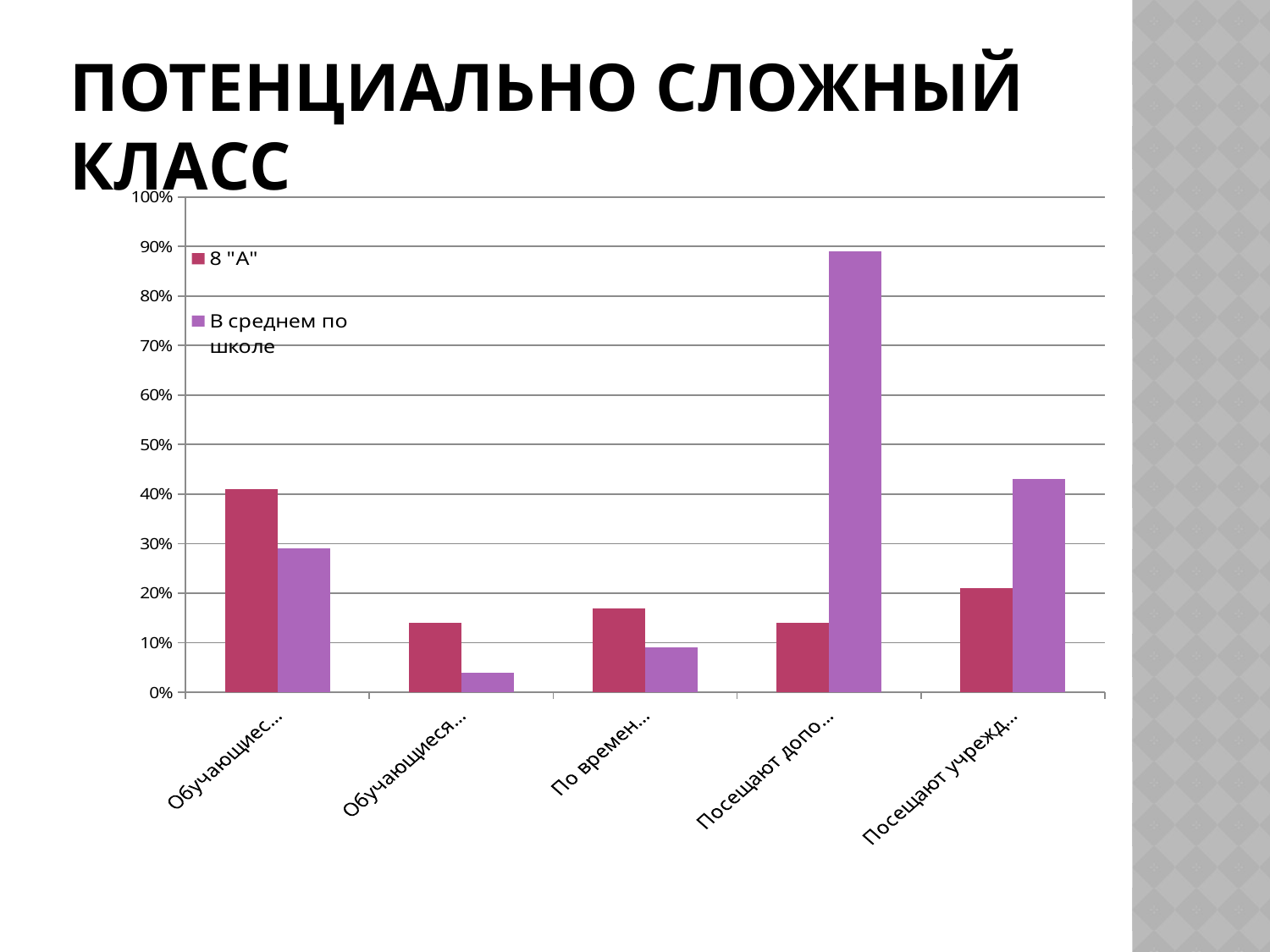
Is the value for 8 "А" in the first category from the left greater or less than 30%? greater In the fifth category from the left, which series has the larger value, 8 "А" or В среднем по школе? В среднем по школе What are the two series named in the legend? 8 "А" and В среднем по школе What colour are the bars for the series 8 "А"? red (crimson) What kind of chart is shown on the slide? bar chart Is the value for В среднем по школе in the second category from the left greater or less than 10%? less In which category does the tallest bar in the chart appear? the fourth category from the left How many categories are plotted along the x axis? 5 Which series has the tallest bar in the chart? В среднем по школе How many series does the legend list? 2 Is the value for В среднем по школе in the fourth category from the left greater or less than 80%? greater In the first category from the left, which series has the larger value, 8 "А" or В среднем по школе? 8 "А"